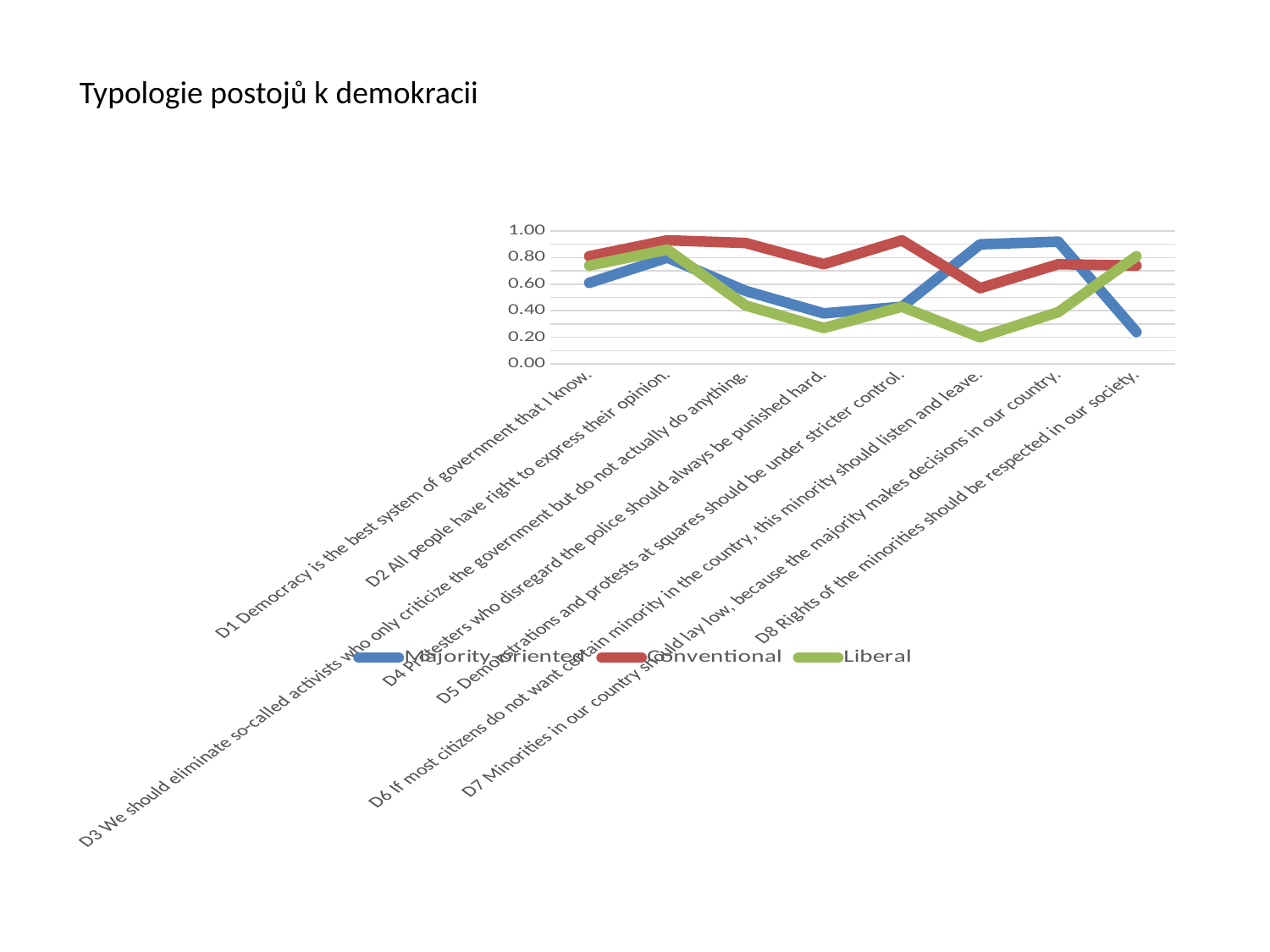
At D8, which series has the larger value: Conventional or Majority-oriented? Conventional How many categories (statements) are plotted along the x axis? 8 For which category is the Conventional series lowest? D6 Is the Conventional value for D5 greater or less than 0.80? greater Is the Liberal value for D6 greater or less than 0.40? less Does the Majority-oriented series rise or fall from D7 to D8? fall How many series does the legend list? 3 Is the Majority-oriented value for D8 greater or less than 0.40? less What kind of chart is shown on the slide? line chart For which category is the Liberal series lowest? D6 At D6, which series has the larger value: Majority-oriented or Liberal? Majority-oriented